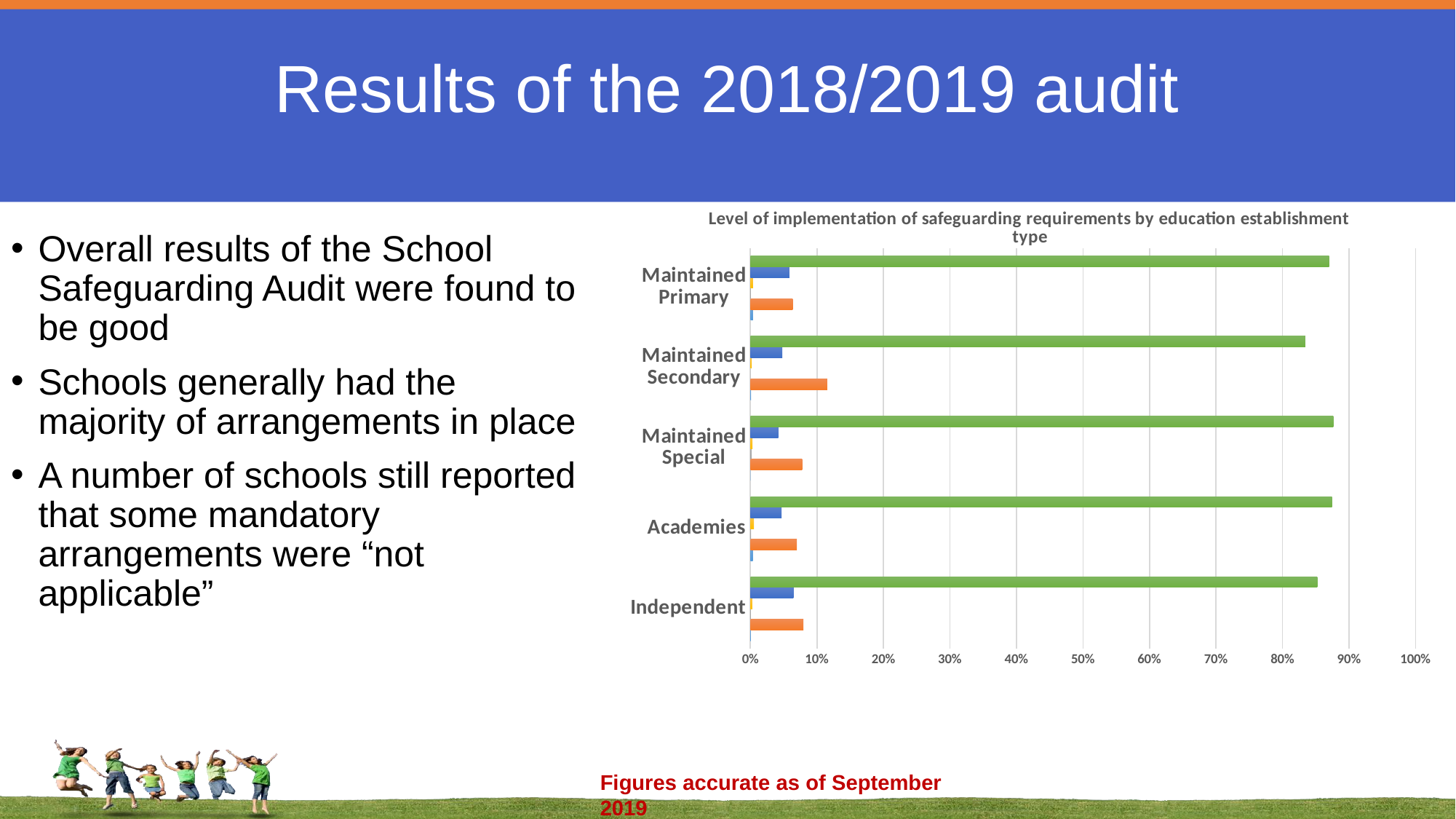
Which is longer, the green bar for Maintained Primary or the green bar for Maintained Secondary? Maintained Primary What is the title of the chart? Level of implementation of safeguarding requirements by education establishment type What is the maximum value shown on the horizontal axis? 100% Is the orange bar for Independent greater or less than 10%? less Which is longer, the orange bar for Maintained Secondary or the orange bar for Academies? Maintained Secondary Is the green bar for Maintained Primary greater or less than 80%? greater How many education establishment types are shown on the chart? 5 What type of chart is shown on the slide? bar chart Is the blue bar for Independent greater or less than 10%? less Which establishment type has the longest orange bar? Maintained Secondary Which establishment type has the shortest green bar? Maintained Secondary